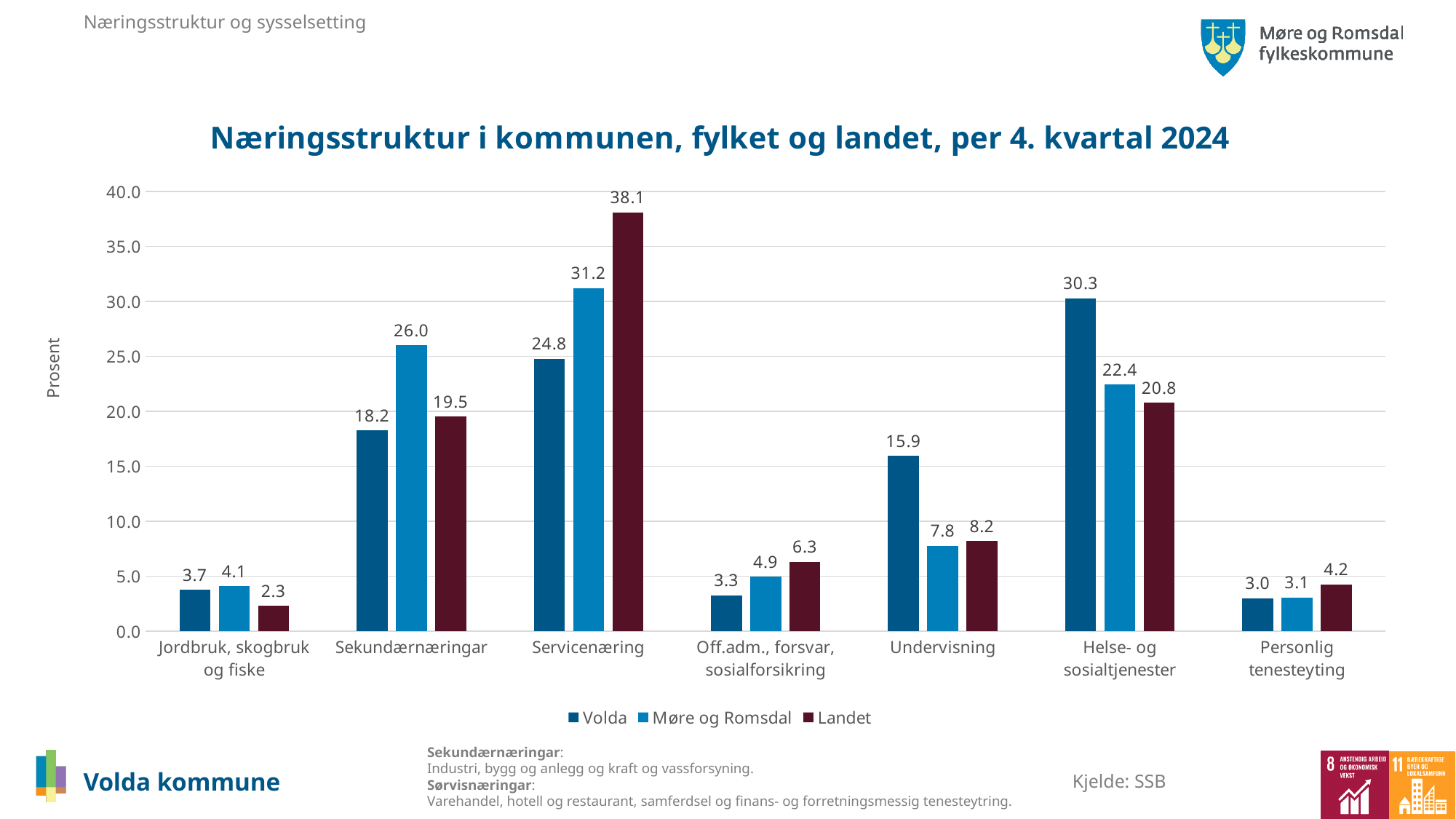
Which category has the highest value for Volda? Helse- og sosialtjenester How many series does the legend list? 3 How many categories are shown on the x axis? 7 Is the value for Møre og Romsdal in Servicenæring greater or less than 30.0? greater In the Undervisning category, which is larger: Volda or Møre og Romsdal? Volda What is the value for Møre og Romsdal in the Sekundærnæringar category? 26.0 What is the value for Volda in the Helse- og sosialtjenester category? 30.3 What kind of chart is shown on the slide? Bar chart What is the value for Landet in the Servicenæring category? 38.1 What is the label of the y axis? Prosent What is the difference between the Landet and Volda values in the Servicenæring category? 13.3 Which category has the lowest value for Landet? Jordbruk, skogbruk og fiske